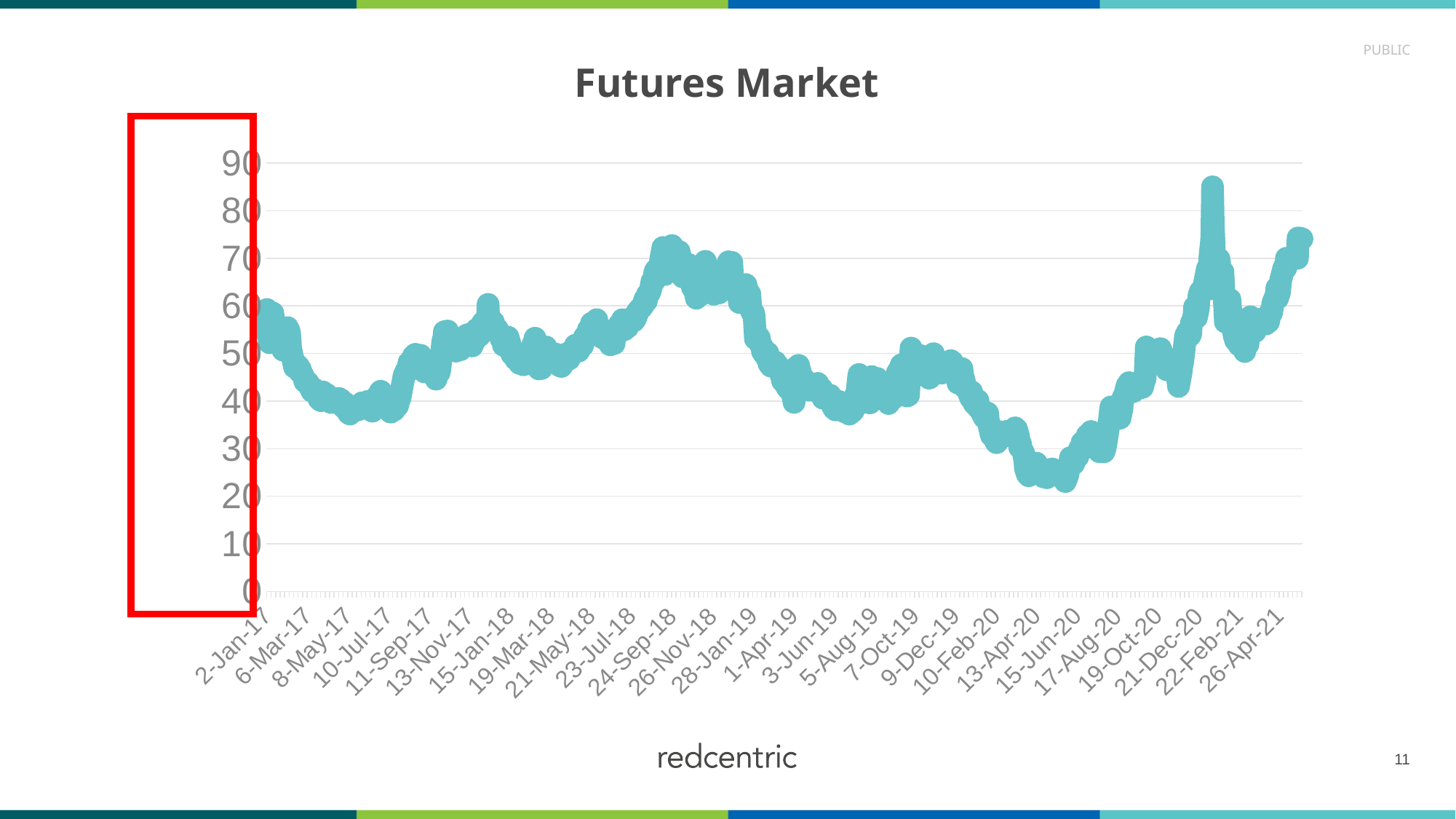
Around which x-axis date does the line reach its lowest point? 15-Jun-20 Does the line rise or fall between 9-Dec-19 and 15-Jun-20? fall Is the peak value around 21-Dec-20 greater or less than 80? greater Is the value at 2-Jan-17 greater or less than 50? greater How many date labels are shown along the x axis? 26 What is the title of the chart? Futures Market Is the value around 15-Jun-20 greater or less than 30? less What is the highest value shown on the vertical axis? 90 What kind of chart is shown on the slide? line chart Around which x-axis date does the line reach its highest point? 21-Dec-20 Which is larger, the peak around 21-Dec-20 or the peak around 24-Sep-18? 21-Dec-20